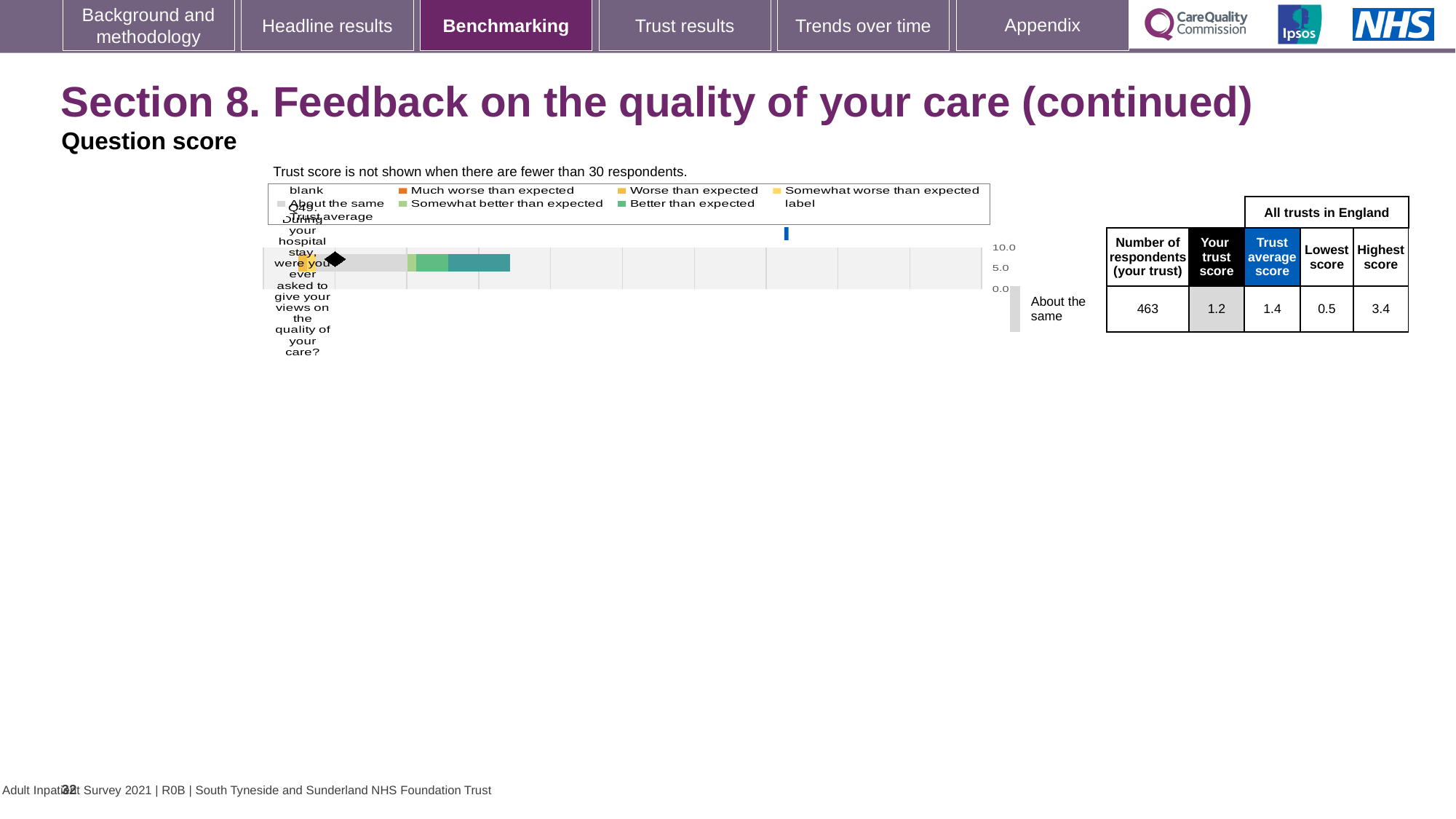
What is the difference between the highest score and the lowest score for Q49? 2.9 What is the highest score among all trusts in England for Q49? 3.4 Which legend entry is shown in orange? Much worse than expected What benchmark category label is shown next to the chart for Q49? About the same What is the number of respondents (your trust) for Q49? 463 Which is larger for Q49: your trust score or the trust average score? Trust average score What is the lowest score among all trusts in England for Q49? 0.5 What is your trust score for Q49? 1.2 What is the difference between the trust average score and your trust score for Q49? 0.2 What kind of chart is shown on the slide? bar chart How many questions are plotted in the chart? 1 What is the trust average score for Q49? 1.4